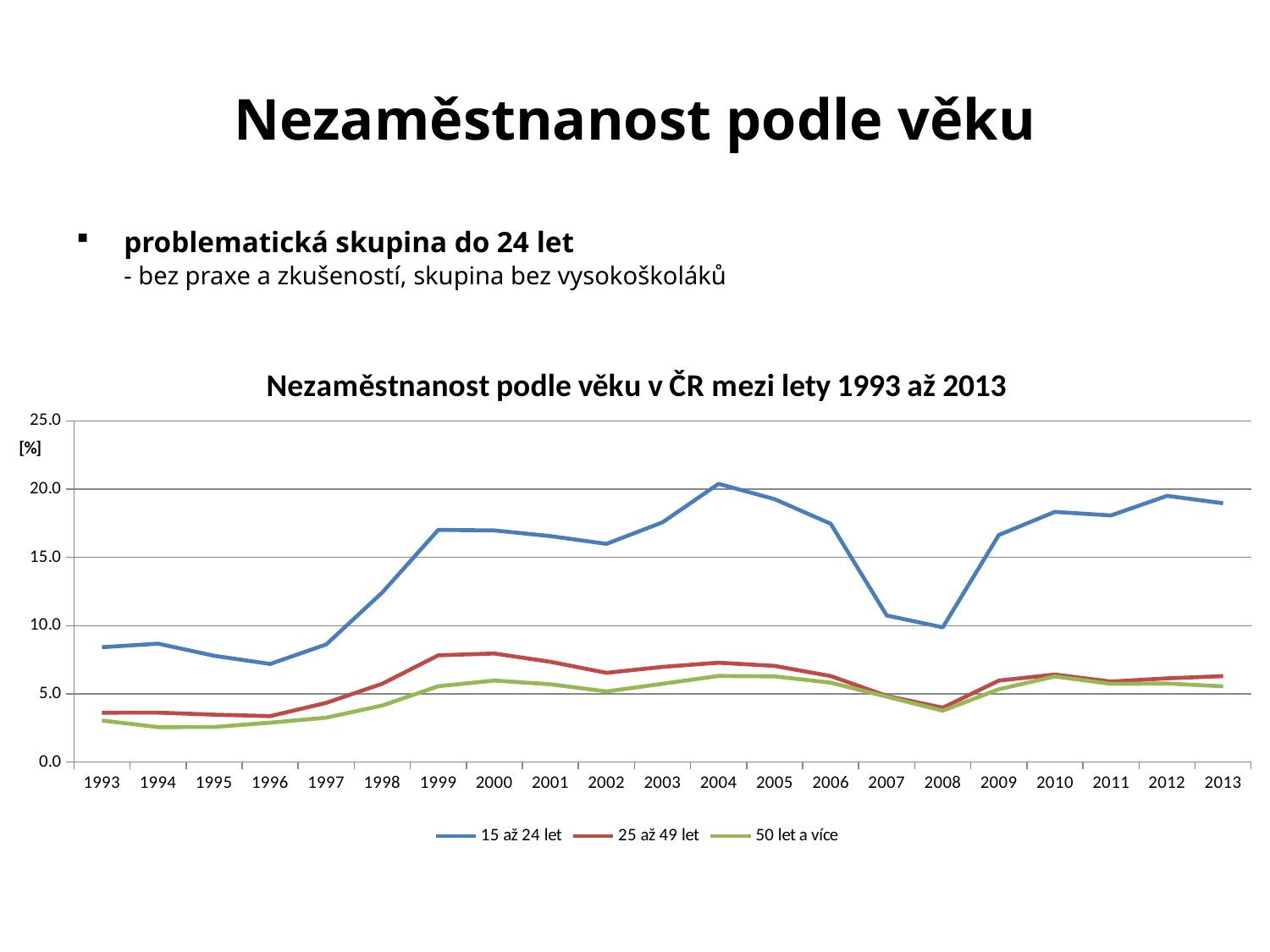
What is the title of the chart? Nezaměstnanost podle věku v ČR mezi lety 1993 až 2013 In which year does the series '15 až 24 let' reach its highest value? 2004 Which is larger for '15 až 24 let': the value in 2004 or the value in 2008? 2004 Does the series '15 až 24 let' rise or fall between 2004 and 2008? fall Which series has the highest value in 2013? 15 až 24 let How many series does the legend of the chart list? 3 In 2000, which series has the larger value: '25 až 49 let' or '50 let a více'? 25 až 49 let Is the value for '25 až 49 let' in 2000 greater or less than 10.0? less Is the value for '15 až 24 let' in 1999 greater or less than 15.0? greater What kind of chart is shown on the slide? line chart How many years are plotted along the x axis of the chart? 21 Is the value for '50 let a více' in 1993 greater or less than 5.0? less